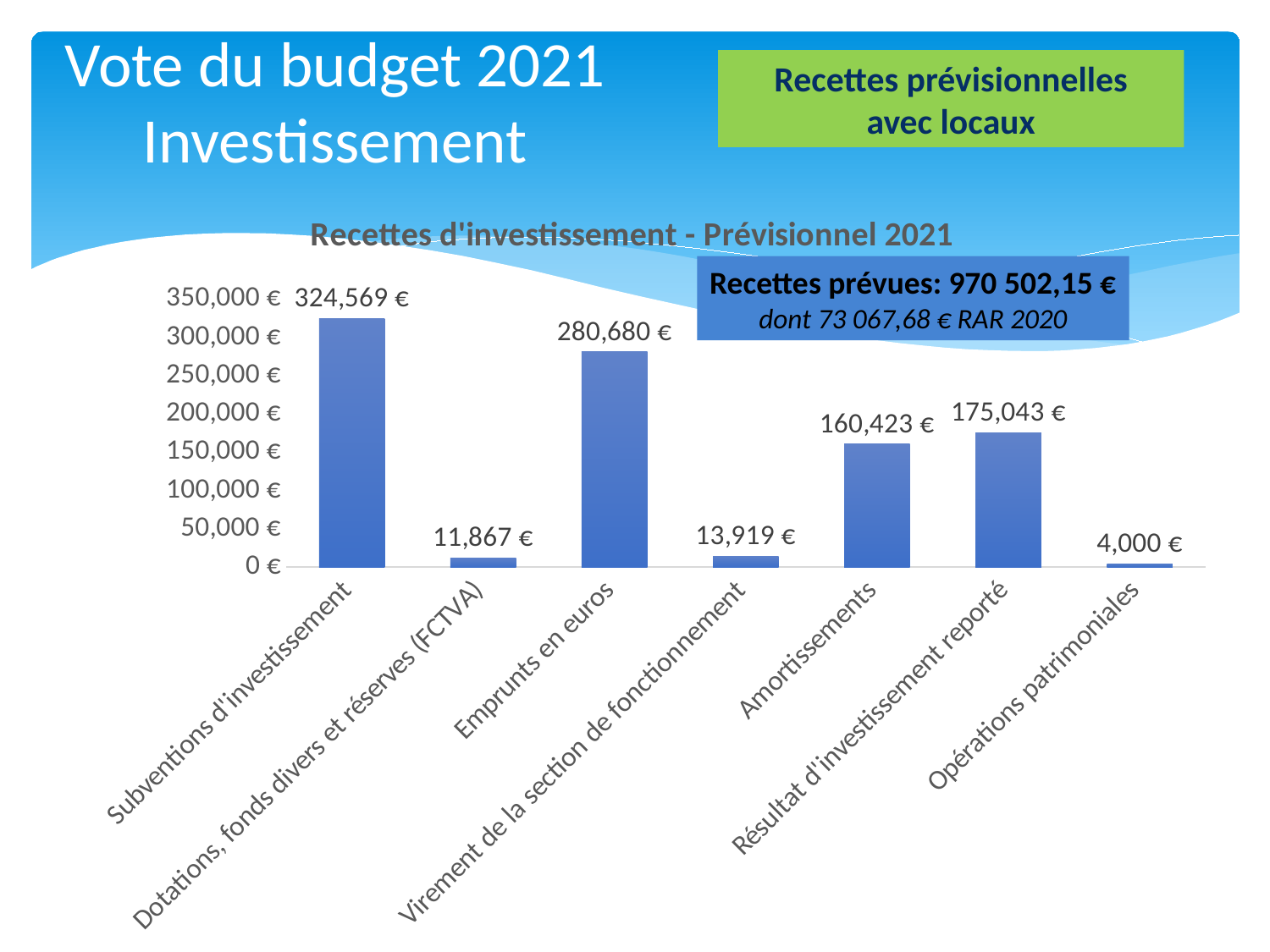
What is the difference between Résultat d'investissement reporté and Amortissements? 14,620 € How many categories are shown in the chart? 7 Which category has the lowest value? Opérations patrimoniales What is the value for Subventions d'investissement? 324,569 € What is the value for Amortissements? 160,423 € What kind of chart is this? Bar chart What is the value for Opérations patrimoniales? 4,000 € Which category has the highest value? Subventions d'investissement Which is larger, Virement de la section de fonctionnement or Dotations, fonds divers et réserves (FCTVA)? Virement de la section de fonctionnement What is the difference between Subventions d'investissement and Emprunts en euros? 43,889 € What is the title of the chart? Recettes d'investissement - Prévisionnel 2021 What is the value for Emprunts en euros? 280,680 €